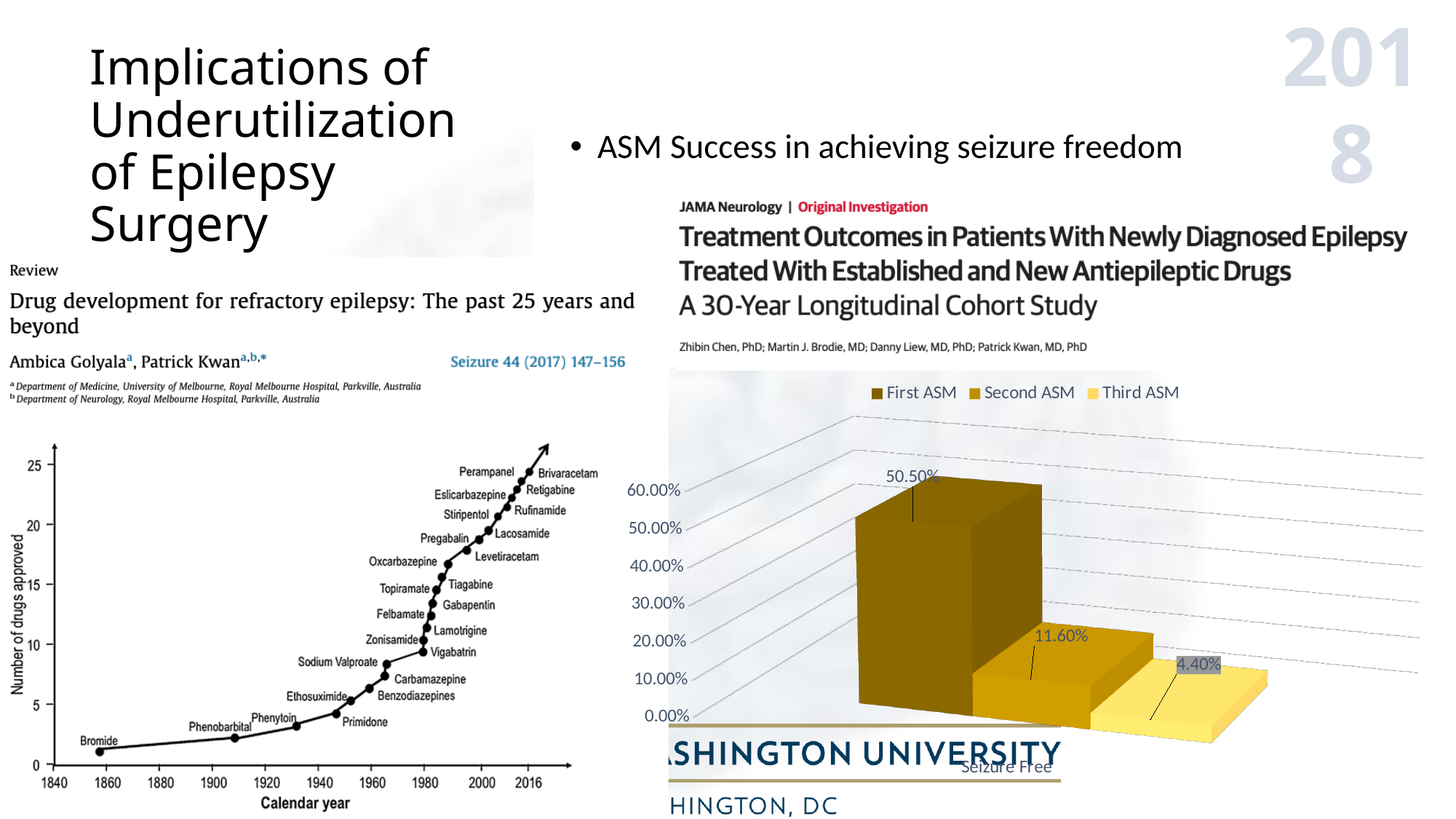
What kind of chart is shown on the right side of the slide? Bar chart On the bar chart on the right, what is the value for Third ASM? 4.40% On the bar chart on the right, which series has the lowest value? Third ASM On the line chart on the left, do the values rise or fall as the calendar year increases? Rise On the bar chart on the right, what is the value for First ASM? 50.50% On the bar chart on the right, what is the value for Second ASM? 11.60% On the bar chart on the right, which series has the highest value? First ASM On the bar chart on the right, how many series does the legend list? 3 On the line chart on the left, what is the label of the y axis? Number of drugs approved On the line chart on the left, is the value for Bromide greater or less than 5? less On the bar chart on the right, what is the difference between the First ASM and Second ASM values? 38.90% On the bar chart on the right, which is larger, Second ASM or Third ASM? Second ASM